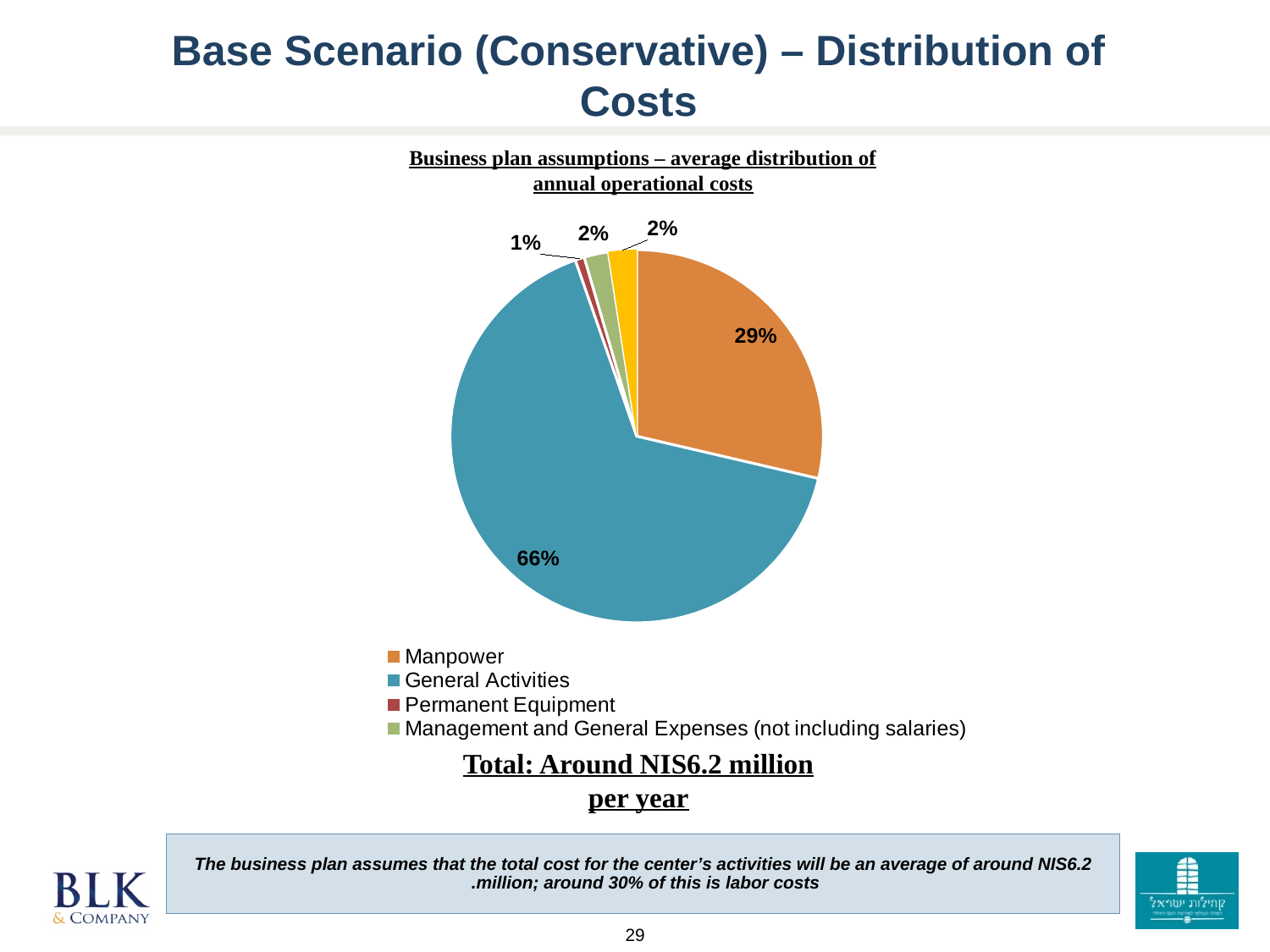
What colour is the Manpower slice in the pie chart? orange How many slices does the pie chart have? 5 What kind of chart is shown on the slide? pie chart What share of annual operational costs is General Activities? 66% What share of annual operational costs is Permanent Equipment? 1% Which category has the smallest share of the pie? Permanent Equipment What share of annual operational costs is Management and General Expenses (not including salaries)? 2% By how many percentage points does the General Activities share exceed the Manpower share? 37% What share of annual operational costs is Manpower? 29% Which category has the largest share of the pie? General Activities Which is larger, the share for Manpower or the share for General Activities? General Activities What is the title of the pie chart? Business plan assumptions – average distribution of annual operational costs